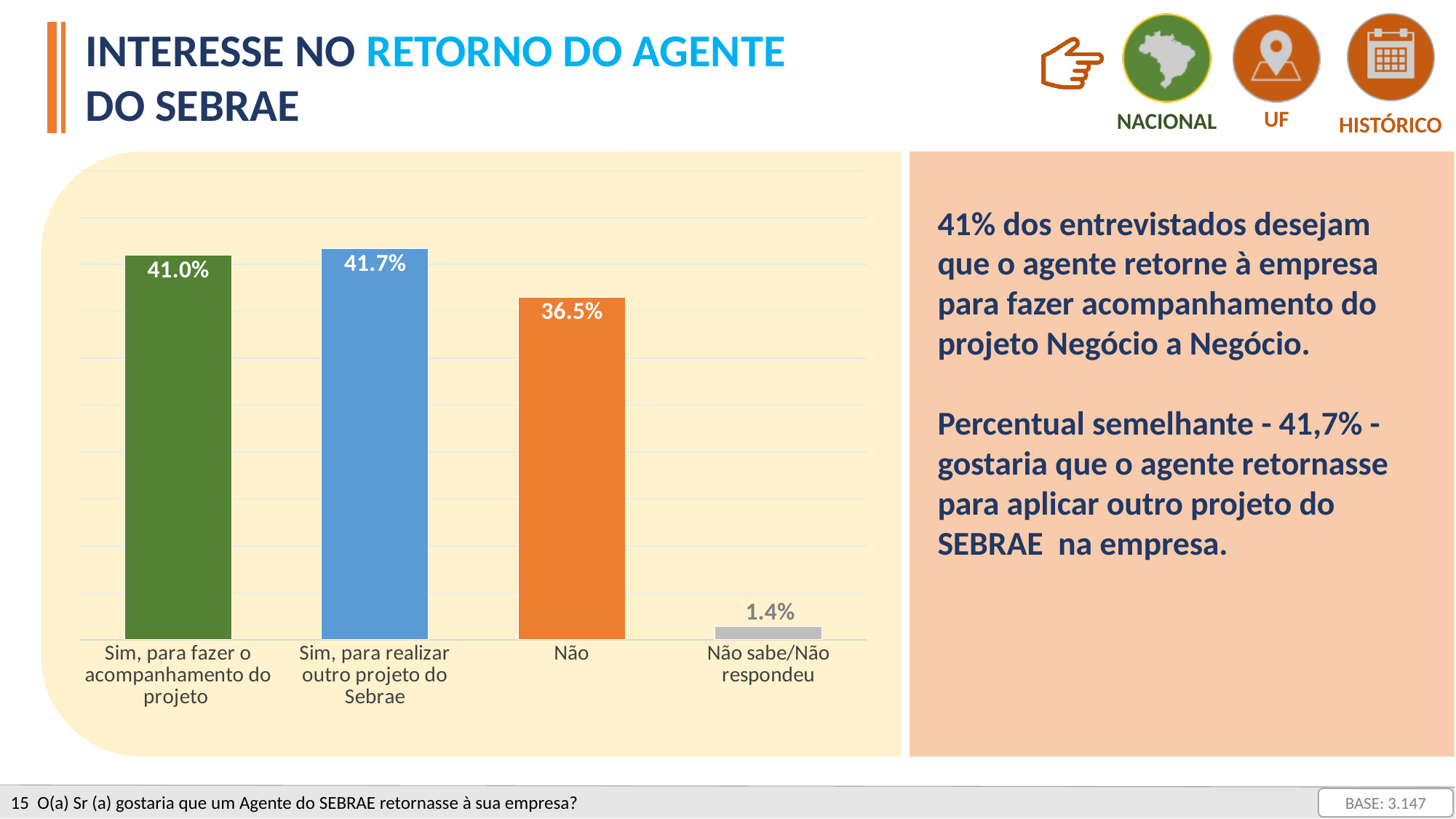
What colour is the bar for "Não"? Orange What is the difference between "Sim, para fazer o acompanhamento do projeto" and "Não sabe/Não respondeu"? 39.6 percentage points What is the value for "Sim, para realizar outro projeto do Sebrae"? 41.7% Which category has the lowest value? Não sabe/Não respondeu Which category has the highest value? Sim, para realizar outro projeto do Sebrae What is the difference between "Sim, para realizar outro projeto do Sebrae" and "Não"? 5.2 percentage points What is the value for "Não"? 36.5% What is the value for "Não sabe/Não respondeu"? 1.4% How many categories are shown in the chart? 4 What is the value for "Sim, para fazer o acompanhamento do projeto"? 41.0% What kind of chart is shown on the slide? Bar chart Which is larger: the value for "Não" or the value for "Sim, para fazer o acompanhamento do projeto"? Sim, para fazer o acompanhamento do projeto